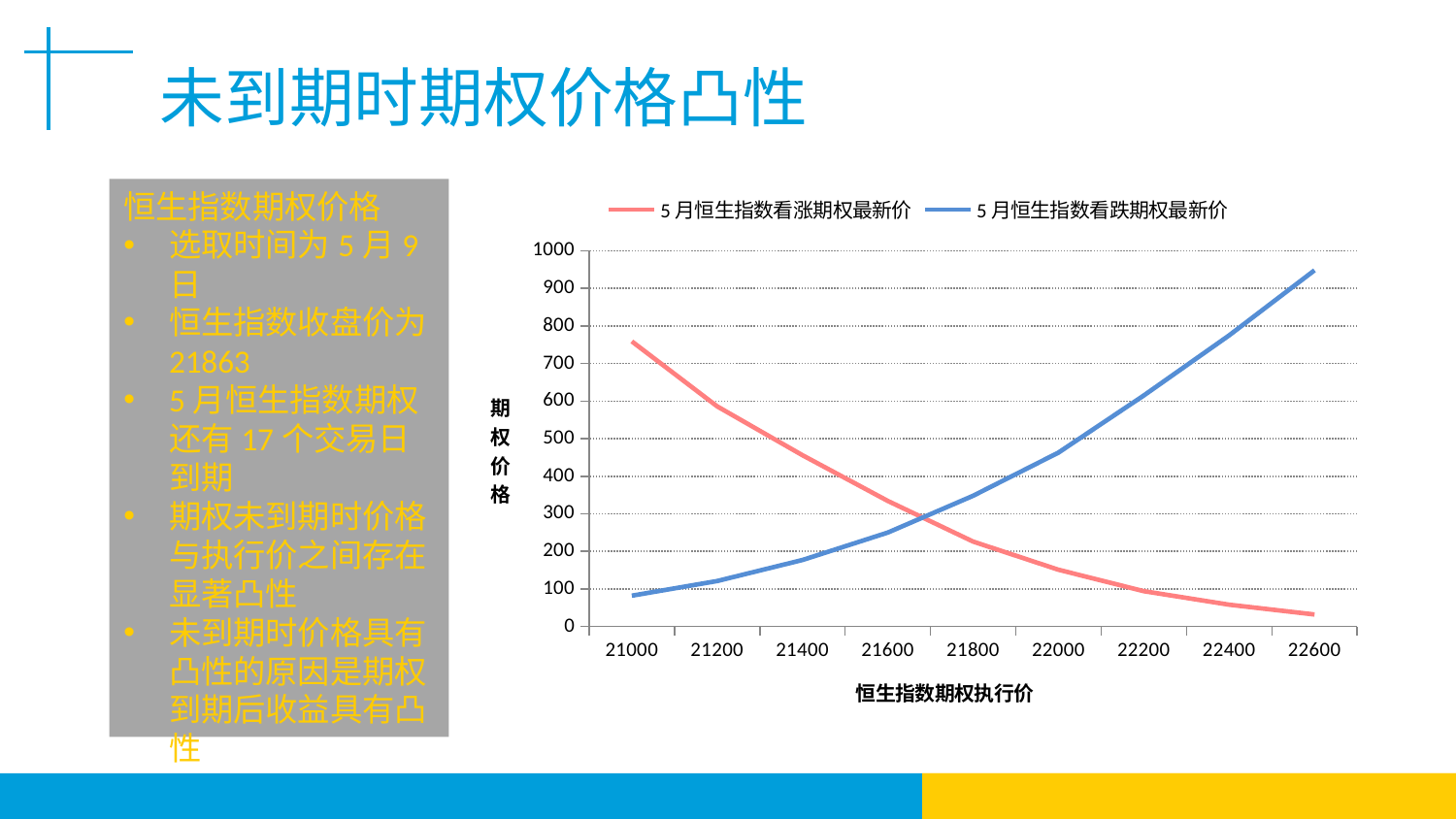
Is the value of 5月恒生指数看涨期权最新价 at strike 21000 greater or less than 700? greater What kind of chart is shown on the slide? line chart How many strike price labels are shown on the x axis? 9 Is the value of 5月恒生指数看跌期权最新价 at strike 21000 greater or less than 200? less Does the value of 5月恒生指数看跌期权最新价 rise or fall as the strike price increases along the x axis? rise At strike 21200, which series has the higher value, 5月恒生指数看涨期权最新价 or 5月恒生指数看跌期权最新价? 5月恒生指数看涨期权最新价 Is the value of 5月恒生指数看跌期权最新价 at strike 22600 greater or less than 900? greater What is the title of the x axis of the chart? 恒生指数期权执行价 At strike 22000, which series has the higher value, 5月恒生指数看涨期权最新价 or 5月恒生指数看跌期权最新价? 5月恒生指数看跌期权最新价 Does the value of 5月恒生指数看涨期权最新价 rise or fall as the strike price increases along the x axis? fall How many series does the chart legend list? 2